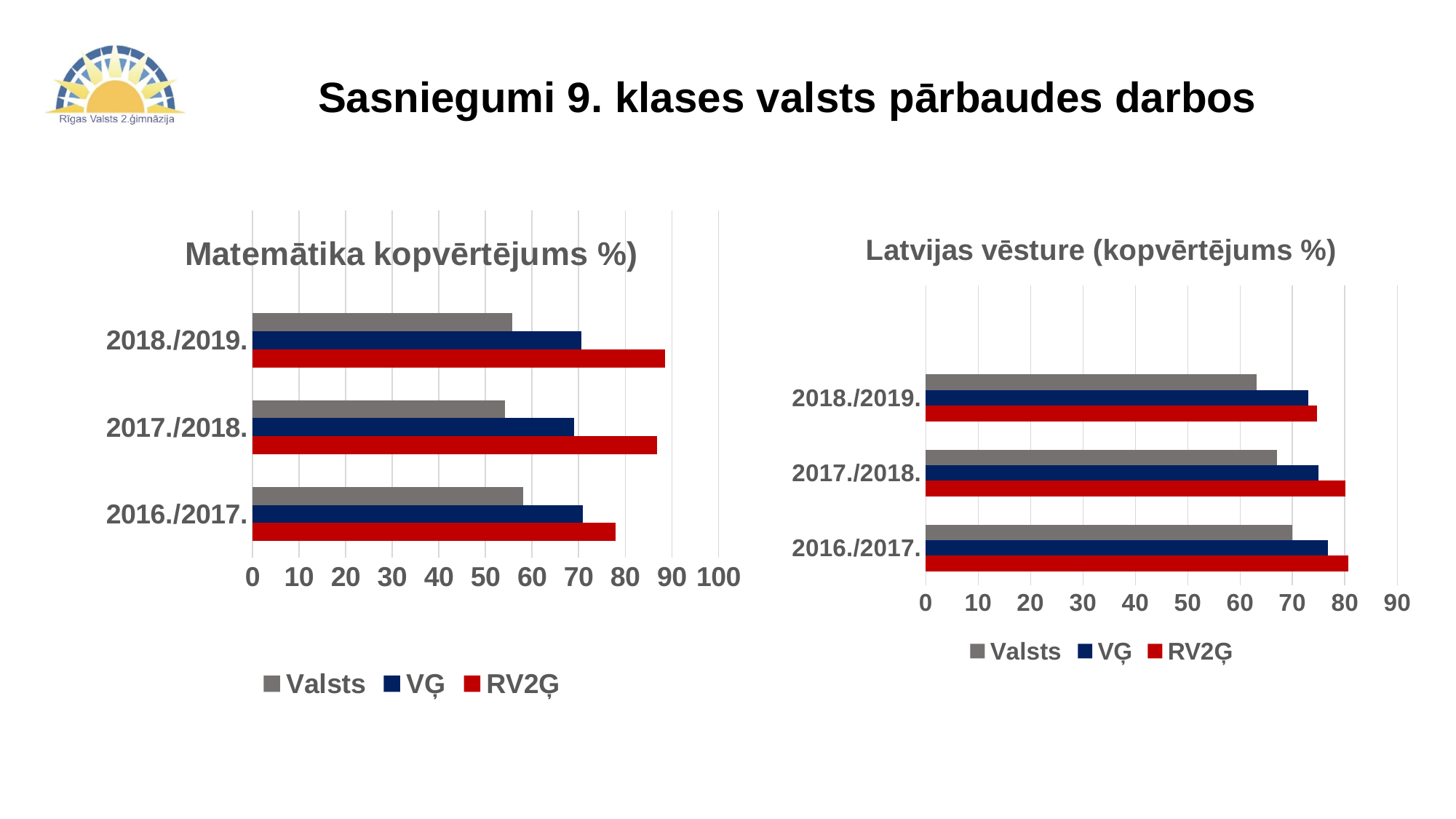
In the Latvijas vēsture (kopvērtējums %) chart, is the value for Valsts in 2018./2019. greater or less than 60? greater In the Matemātika kopvērtējums %) chart, is the value for RV2Ģ in 2018./2019. greater or less than 80? greater In the Latvijas vēsture (kopvērtējums %) chart, which is larger for 2016./2017., Valsts or VĢ? VĢ What kind of chart is the Latvijas vēsture (kopvērtējums %) chart? bar chart In the Latvijas vēsture (kopvērtējums %) chart, is the value for RV2Ģ in 2017./2018. greater or less than 70? greater How many series does the legend of the Latvijas vēsture (kopvērtējums %) chart list? 3 In the Latvijas vēsture (kopvērtējums %) chart, which series has the lowest value for 2018./2019.? Valsts How many school years are shown in the Matemātika kopvērtējums %) chart? 3 In the Matemātika kopvērtējums %) chart, which series has the highest value for 2017./2018.? RV2Ģ In the Matemātika kopvērtējums %) chart, which is larger for 2018./2019., Valsts or RV2Ģ? RV2Ģ